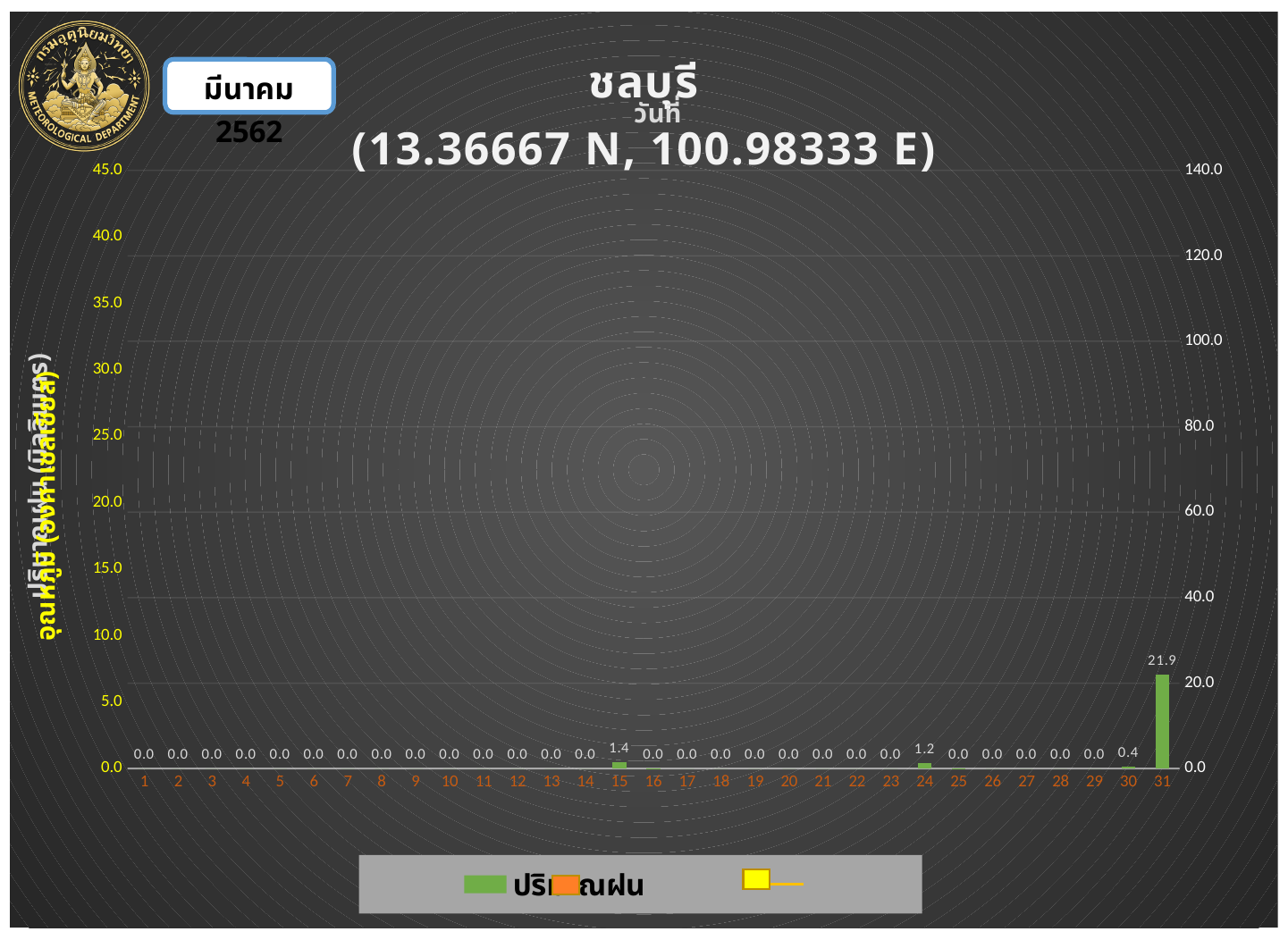
What kind of chart is shown on the slide? bar chart What is the rainfall value shown for day 15? 1.4 What coordinates are given in the chart title? 13.36667 N, 100.98333 E What is the rainfall value shown for day 30? 0.4 Which day has the larger rainfall value, day 15 or day 24? 15 What is the rainfall value shown for day 31? 21.9 Is the value for day 31 greater or less than 20.0 on the right axis? greater How many days are shown on the x axis? 31 What is the difference between the rainfall values for day 31 and day 15? 20.5 Which day has the highest rainfall value? 31 What is the rainfall value shown for day 24? 1.2 What is the rainfall value shown for day 1? 0.0